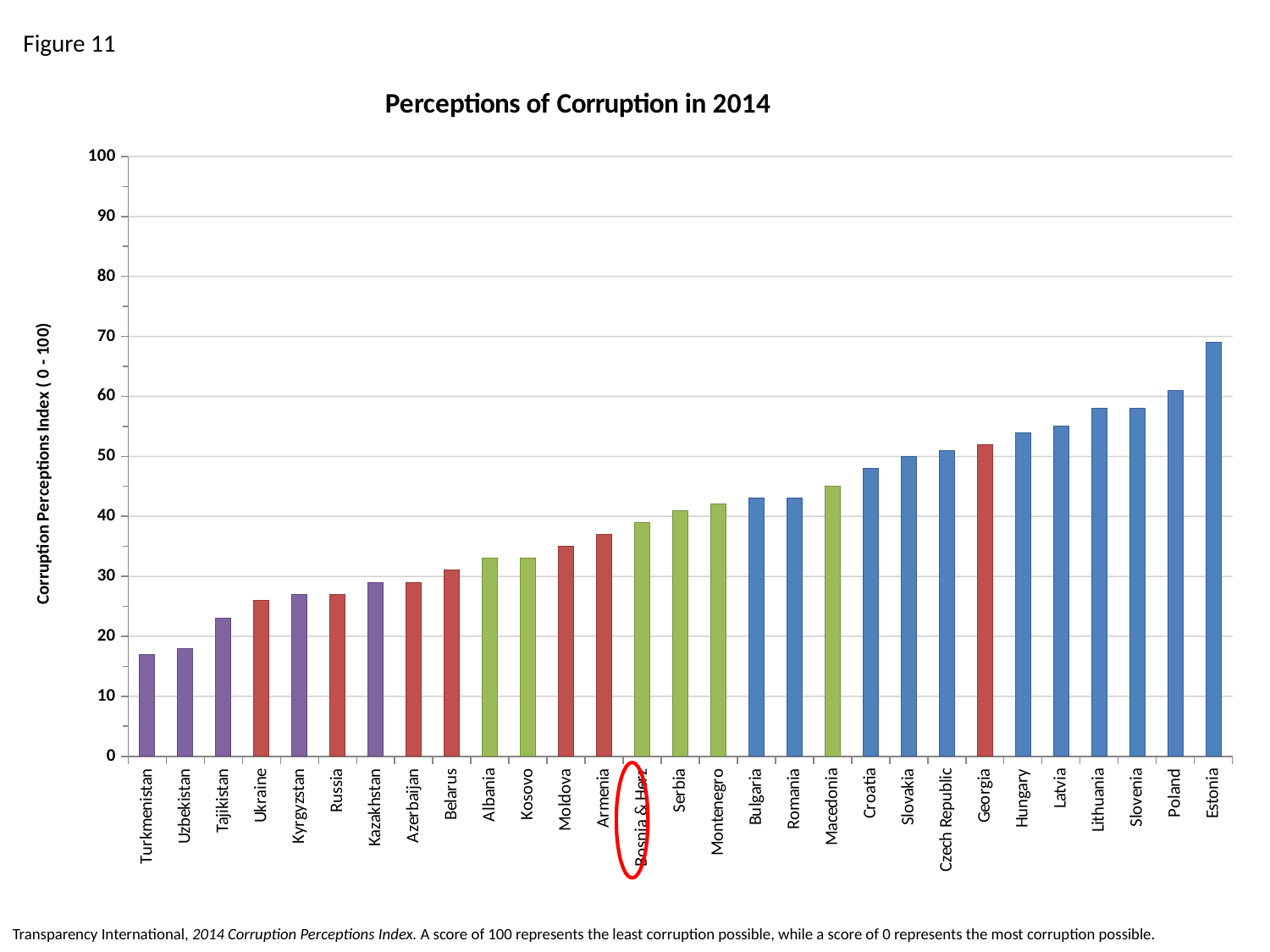
Is the value for Macedonia greater or less than 40? greater Is the value for Moldova greater or less than 40? less Is the value for Hungary greater or less than 50? greater Which has a higher value, Estonia or Poland? Estonia What is the title of the chart? Perceptions of Corruption in 2014 Which country has the highest Corruption Perceptions Index value in the chart? Estonia What kind of chart is shown on the slide? bar chart How many countries are shown on the x axis of the chart? 29 Do the values generally rise or fall moving from left to right along the x axis? rise